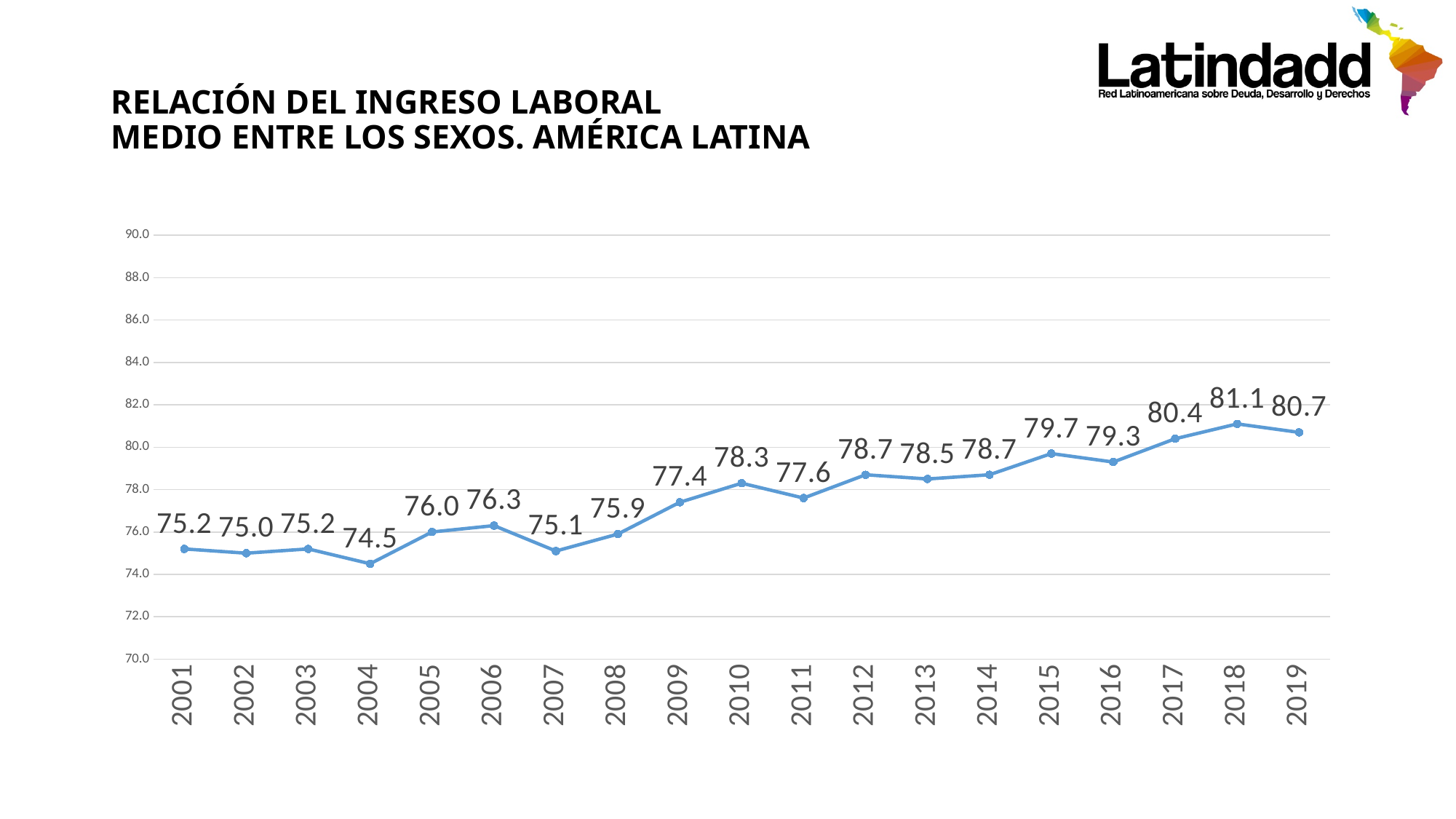
How many years are plotted on the chart? 19 Is the value for 2015 greater or less than 78.0? greater Do the values generally rise or fall from 2001 to 2019? Rise What is the value for 2004? 74.5 Which year has the lowest value? 2004 What is the title of the chart? RELACIÓN DEL INGRESO LABORAL MEDIO ENTRE LOS SEXOS. AMÉRICA LATINA What is the value for 2010? 78.3 What is the difference between the values for 2018 and 2001? 5.9 What kind of chart is shown on the slide? Line chart Which year has the highest value? 2018 What is the value for 2019? 80.7 Which is larger, the value for 2011 or the value for 2012? 2012